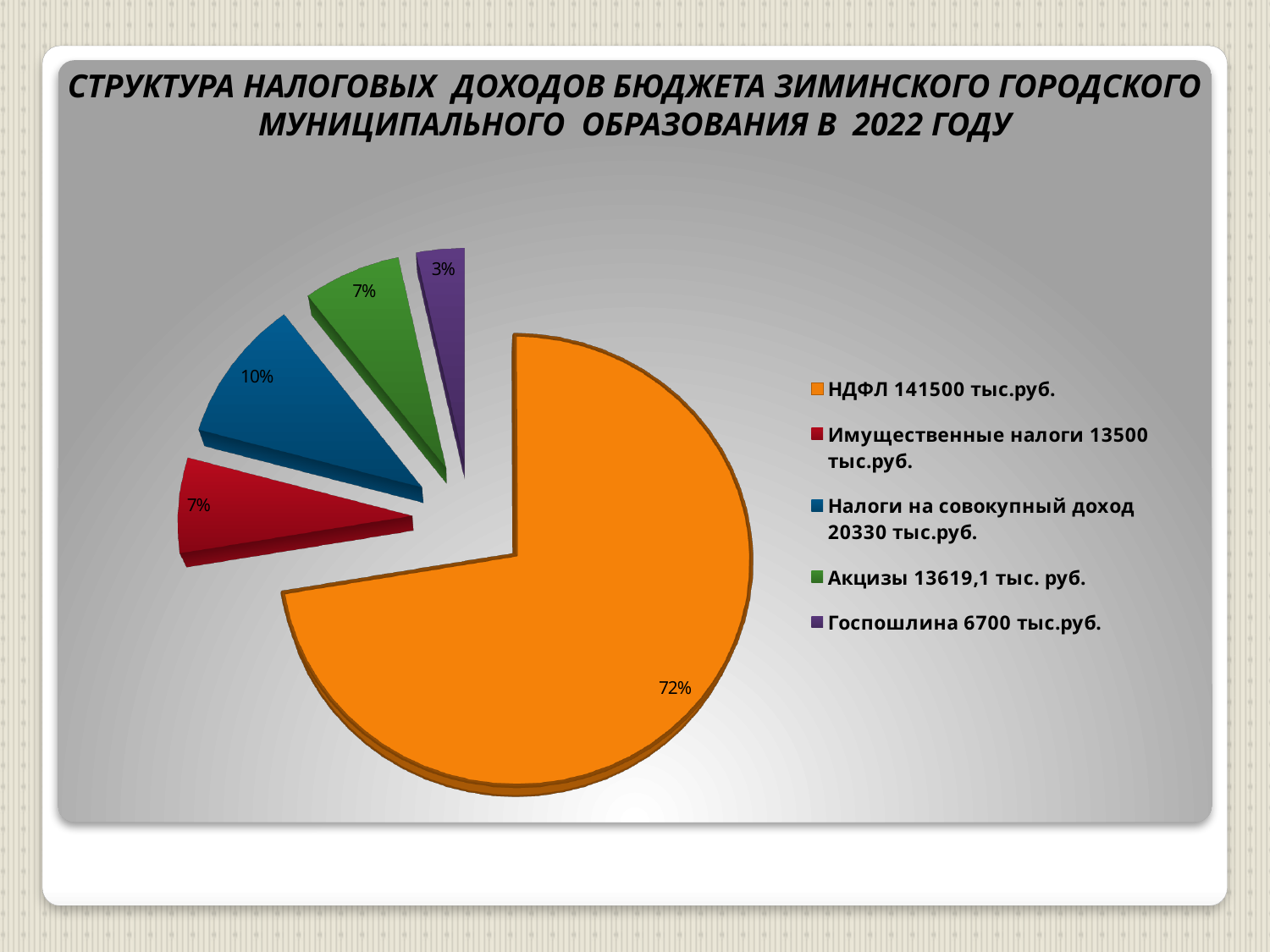
What is the difference in percentage points between the share of НДФЛ and the share of Налоги на совокупный доход? 62 Which category has the largest slice of the pie chart? НДФЛ What colour is the slice for Имущественные налоги? red What kind of chart is shown on the slide? pie chart What percentage share does Акцизы have in the pie chart? 7% What percentage share does Налоги на совокупный доход have in the pie chart? 10% What percentage share does НДФЛ have in the pie chart? 72% How many slices does the pie chart have? 5 What percentage share does Госпошлина have in the pie chart? 3% Which is larger: the share of Налоги на совокупный доход or the share of Госпошлина? Налоги на совокупный доход Which category has the smallest slice of the pie chart? Госпошлина According to the legend, what amount in тыс.руб. is given for Акцизы? 13619,1 тыс. руб.